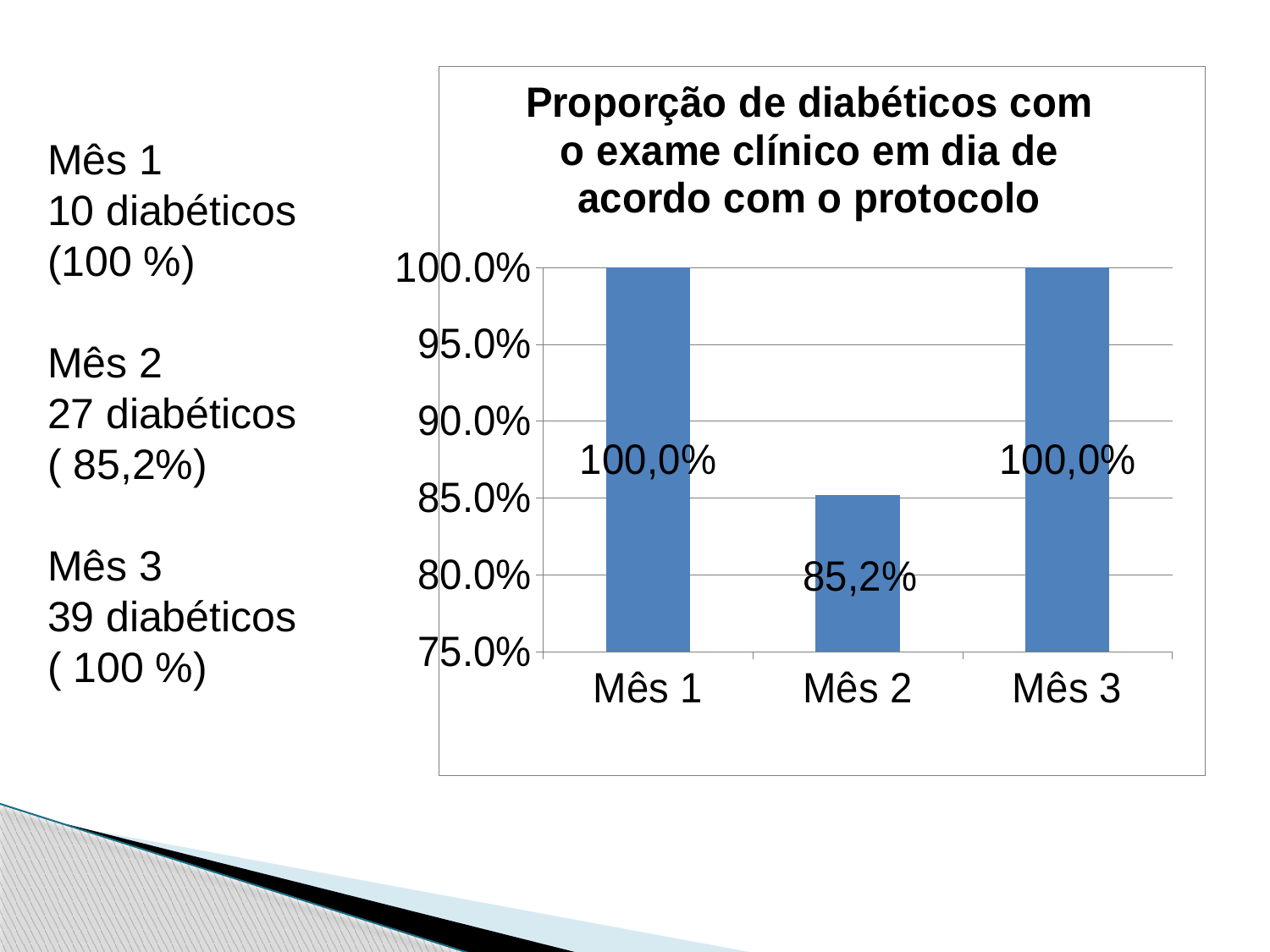
Which month has the lowest value? Mês 2 What is the title of the chart? Proporção de diabéticos com o exame clínico em dia de acordo com o protocolo How many months are shown on the x axis? 3 Does the value rise or fall from Mês 2 to Mês 3? rise What is the value for Mês 2? 85,2% What is the value for Mês 3? 100,0% Is the value for Mês 2 greater or less than 90.0%? less What is the value for Mês 1? 100,0% What is the lowest value shown on the y axis? 75.0% Which is larger, the value for Mês 2 or the value for Mês 3? Mês 3 What kind of chart is shown? bar chart What is the difference between the values for Mês 1 and Mês 2? 14,8%